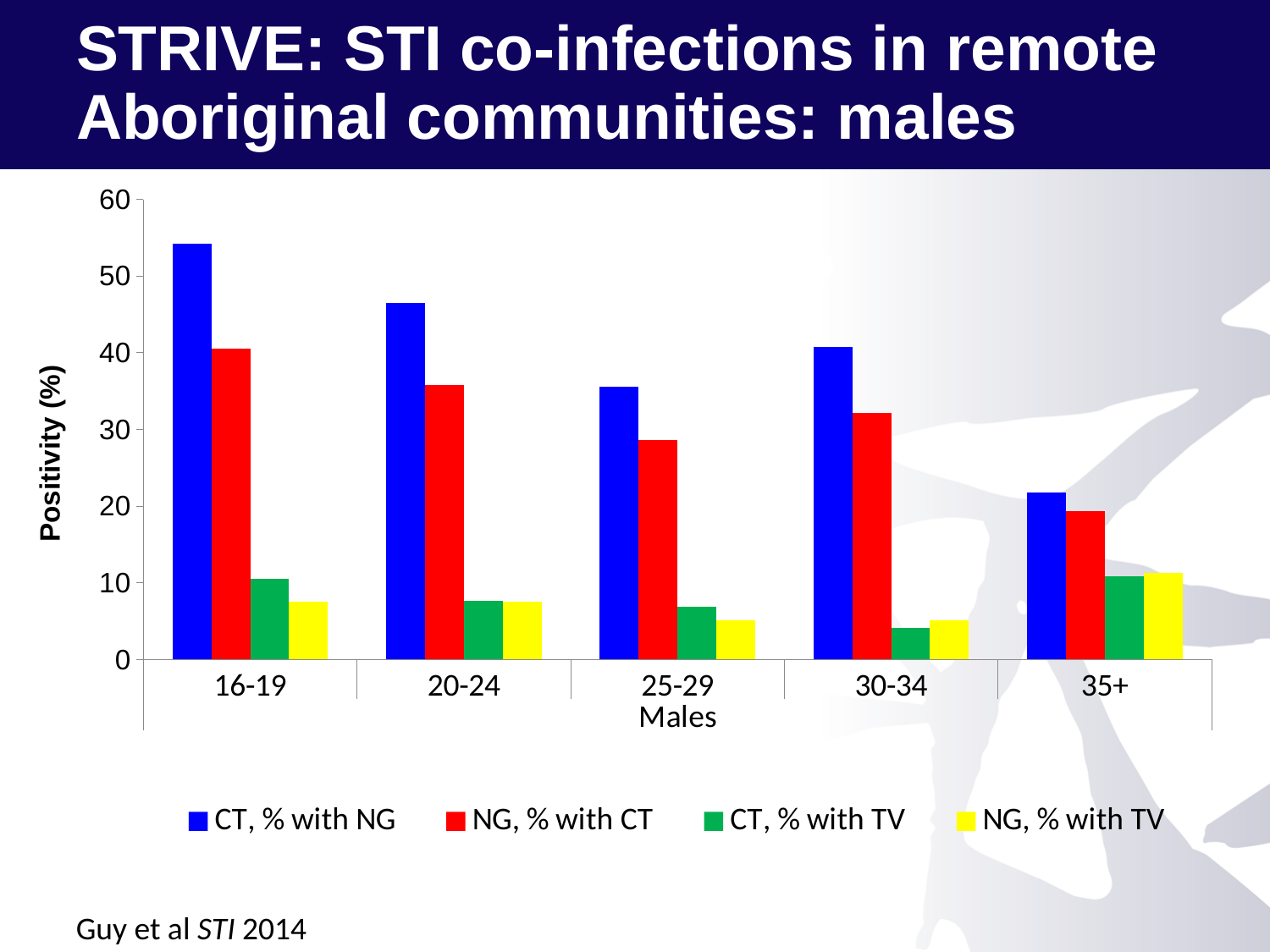
Which age group has the highest value for CT, % with NG? 16-19 Which age group has the lowest value for CT, % with NG? 35+ Which is larger: CT, % with NG for the 20-24 age group or for the 30-34 age group? 20-24 Is the value for CT, % with NG in the 35+ age group greater or less than 30? less What colour represents the series NG, % with TV? Yellow What kind of chart is shown on the slide? Bar chart How many series does the legend list? 4 How many age groups are shown on the x axis? 5 Is the value for NG, % with CT in the 25-29 age group greater or less than 30? less Which age group has the lowest value for CT, % with TV? 30-34 Is the value for CT, % with NG in the 16-19 age group greater or less than 50? greater What is the title of the y axis? Positivity (%)